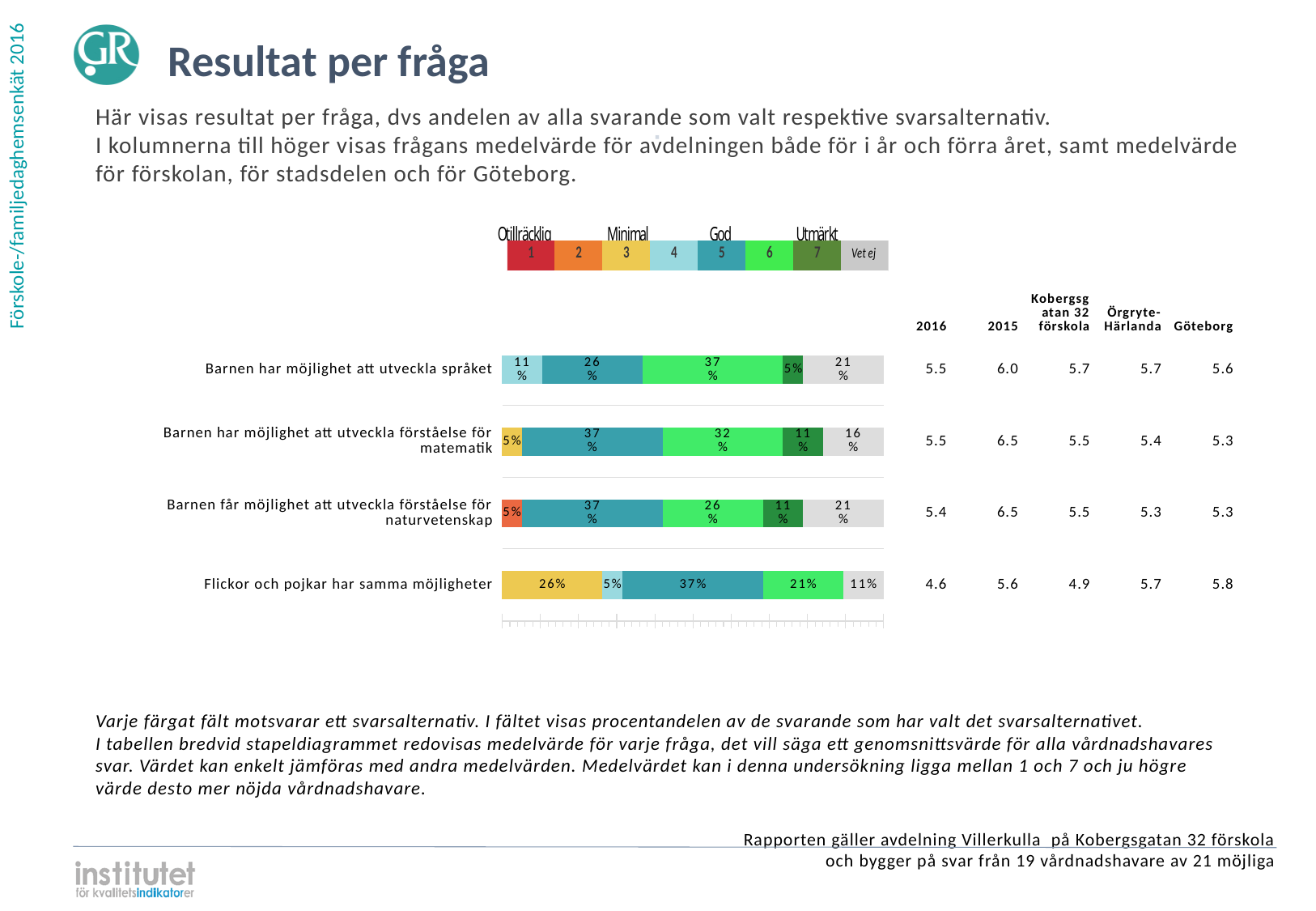
What percentage chose answer 3 (the yellow segment) for 'Flickor och pojkar har samma möjligheter'? 26% What percentage chose answer 6 (the bright green segment) for 'Barnen har möjlighet att utveckla förståelse för matematik'? 32% What is the difference between the 2015 and 2016 mean values for 'Barnen har möjlighet att utveckla förståelse för matematik'? 1.0 What is the Göteborg mean value for 'Barnen har möjlighet att utveckla språket'? 5.6 Which answer option in the legend is shown in grey? Vet ej Which question has the lowest 2016 mean value? Flickor och pojkar har samma möjligheter What kind of chart is shown on the slide? Stacked bar chart What is the 2015 mean value for 'Barnen får möjlighet att utveckla förståelse för naturvetenskap'? 6.5 What is the 2016 mean value for 'Flickor och pojkar har samma möjligheter'? 4.6 How many questions (categories) are plotted in the bar chart? 4 For 'Flickor och pojkar har samma möjligheter', which is higher: the Göteborg mean or the 2016 mean? Göteborg What percentage of respondents answered 'Vet ej' for 'Barnen har möjlighet att utveckla språket'? 21%